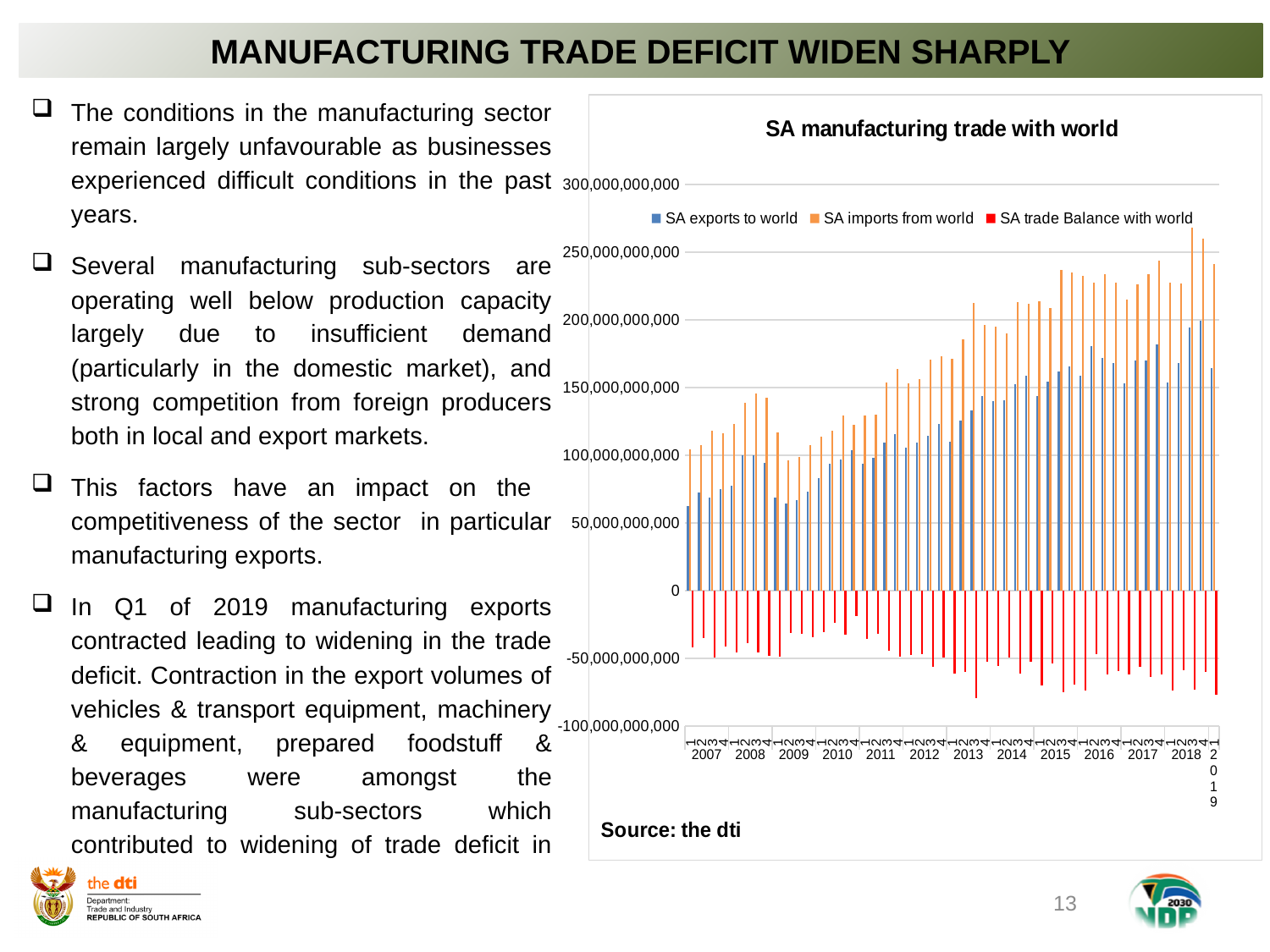
Is the value of SA exports to world in Q1 2016 greater or less than 150,000,000,000? greater Is the value of SA imports from world in Q3 2018 greater or less than 250,000,000,000? greater Is the value of SA trade Balance with world in Q1 2019 greater or less than -50,000,000,000? less Overall, do the SA imports from world values rise or fall from 2007 to 2018? rise How many years are labelled along the x axis of the chart? 13 Which series is shown in red in the chart? SA trade Balance with world What is the title of the chart? SA manufacturing trade with world Which series has the tallest bar in the chart? SA imports from world How many series does the chart's legend list? 3 In Q3 2018, which is larger: SA exports to world or SA imports from world? SA imports from world What type of chart is shown on the slide? Bar chart